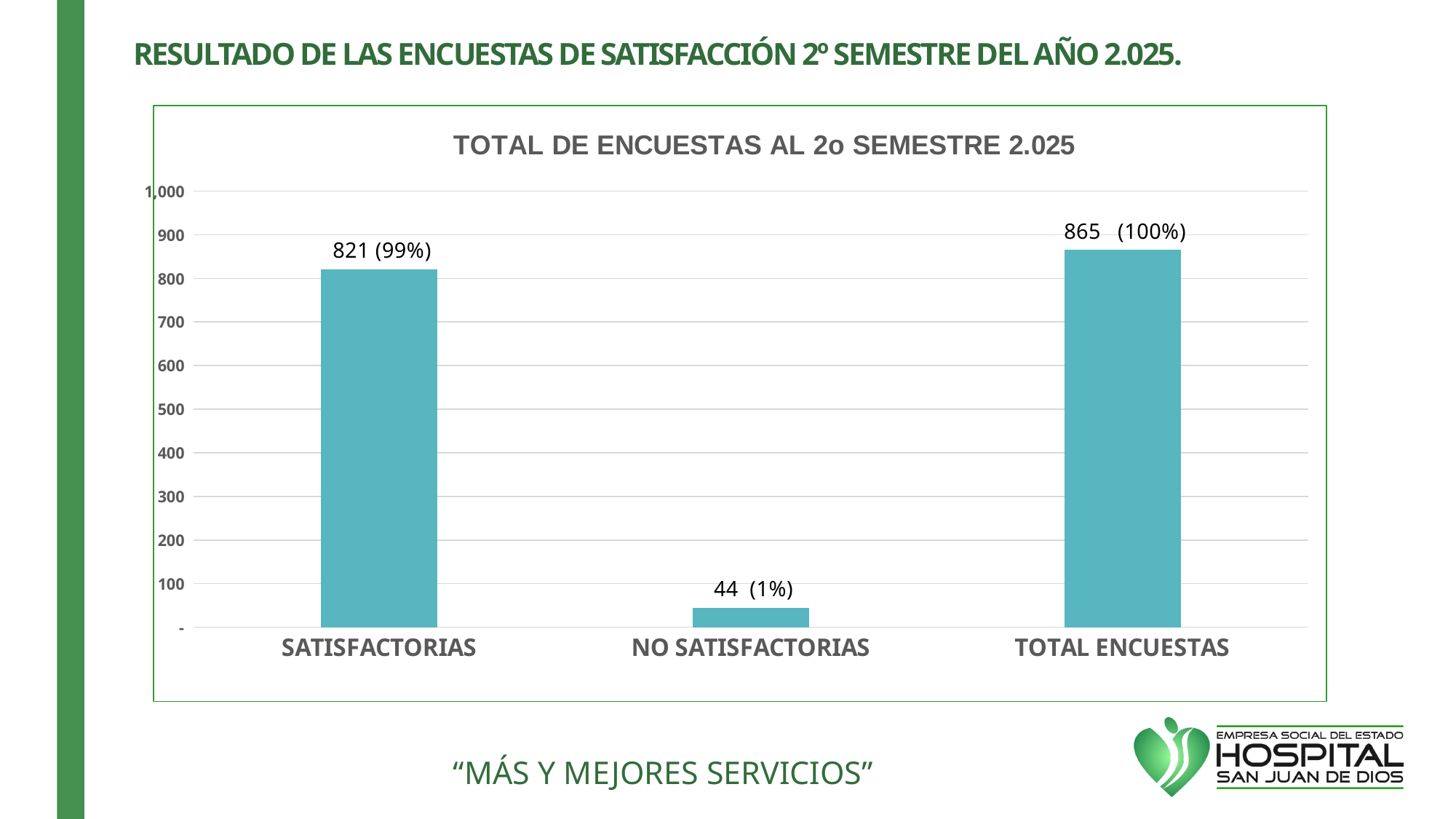
Which is larger, the value for SATISFACTORIAS or the value for NO SATISFACTORIAS? SATISFACTORIAS Is the value for SATISFACTORIAS greater or less than 800? greater What kind of chart is shown on the slide? Bar chart Which category has the lowest value? NO SATISFACTORIAS What is the value shown for NO SATISFACTORIAS? 44 (1%) How many categories are shown on the x axis? 3 What is the difference between the values for SATISFACTORIAS and NO SATISFACTORIAS? 777 What is the value shown for TOTAL ENCUESTAS? 865 (100%) Is the value for NO SATISFACTORIAS greater or less than 100? less What is the value shown for SATISFACTORIAS? 821 (99%) Which category has the highest value? TOTAL ENCUESTAS What is the title of the chart? TOTAL DE ENCUESTAS AL 2o SEMESTRE 2.025